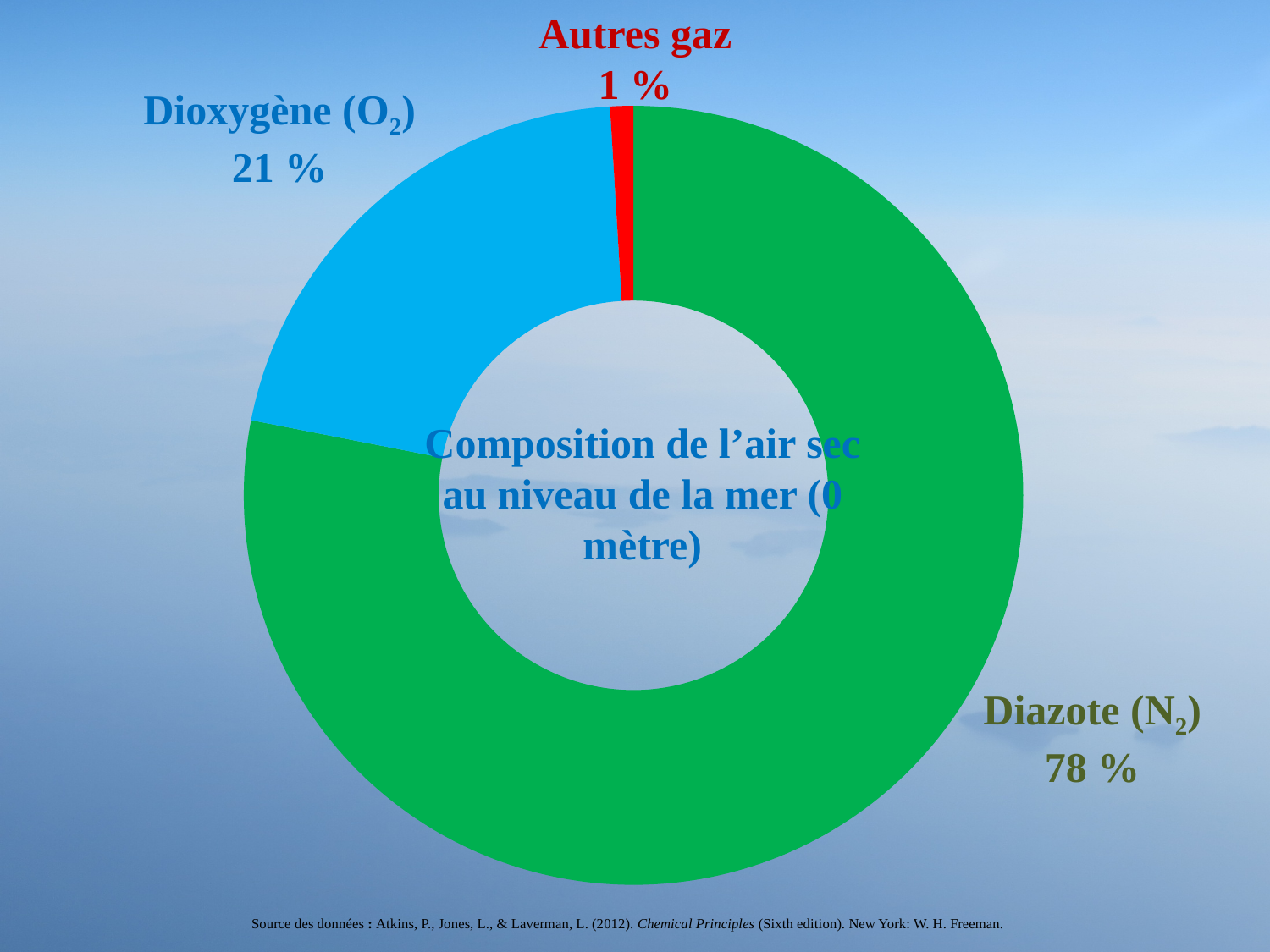
What share of dry air do the Autres gaz represent according to the chart? 1 % Which is larger, the share of Dioxygène (O2) or the share of Autres gaz? Dioxygène (O2) What share of dry air does Diazote (N2) represent according to the chart? 78 % What share of dry air does Dioxygène (O2) represent according to the chart? 21 % Which gas has the largest share in the chart? Diazote (N2) What is the title of the chart? Composition de l'air sec au niveau de la mer (0 mètre) Which category has the smallest share in the chart? Autres gaz What is the difference between the shares of Diazote (N2) and Dioxygène (O2)? 57 % What kind of chart is shown on the slide? Doughnut (pie) chart What colour is the slice for Diazote (N2)? Green How many categories are shown in the chart? 3 What is the difference between the shares of Dioxygène (O2) and Autres gaz? 20 %